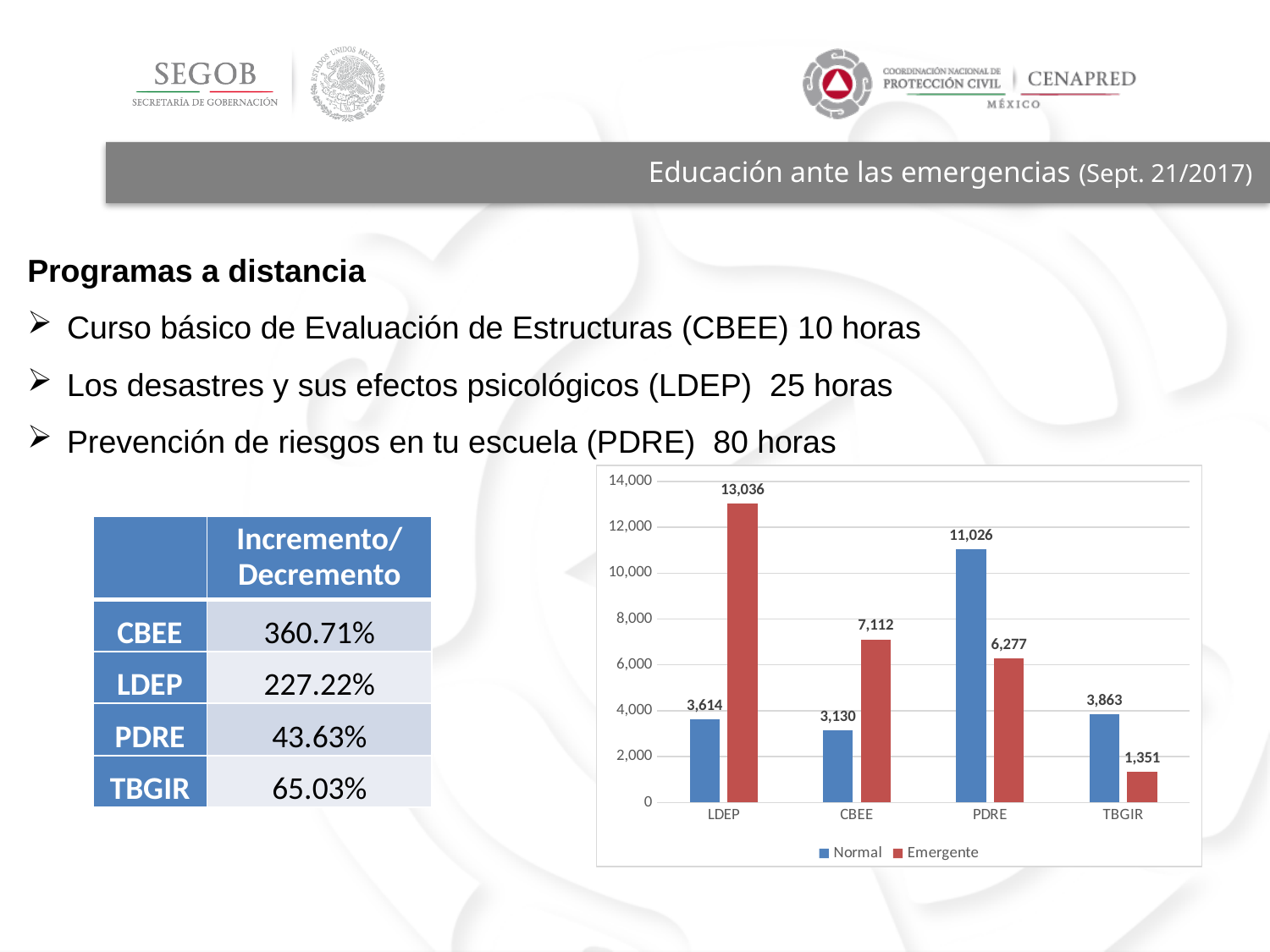
What is the Normal value for PDRE? 11,026 For TBGIR, which is larger, the Normal value or the Emergente value? Normal What is the Normal value for LDEP? 3,614 What is the difference between the Normal and Emergente values for PDRE? 4,749 What is the Emergente value for CBEE? 7,112 How many categories are shown on the x axis of the chart? 4 Which category has the highest Emergente value? LDEP How many series does the chart legend list? 2 Which category has the lowest Emergente value? TBGIR What is the difference between the Emergente and Normal values for LDEP? 9,422 Which category has the lowest Normal value? CBEE What is the Emergente value for LDEP? 13,036